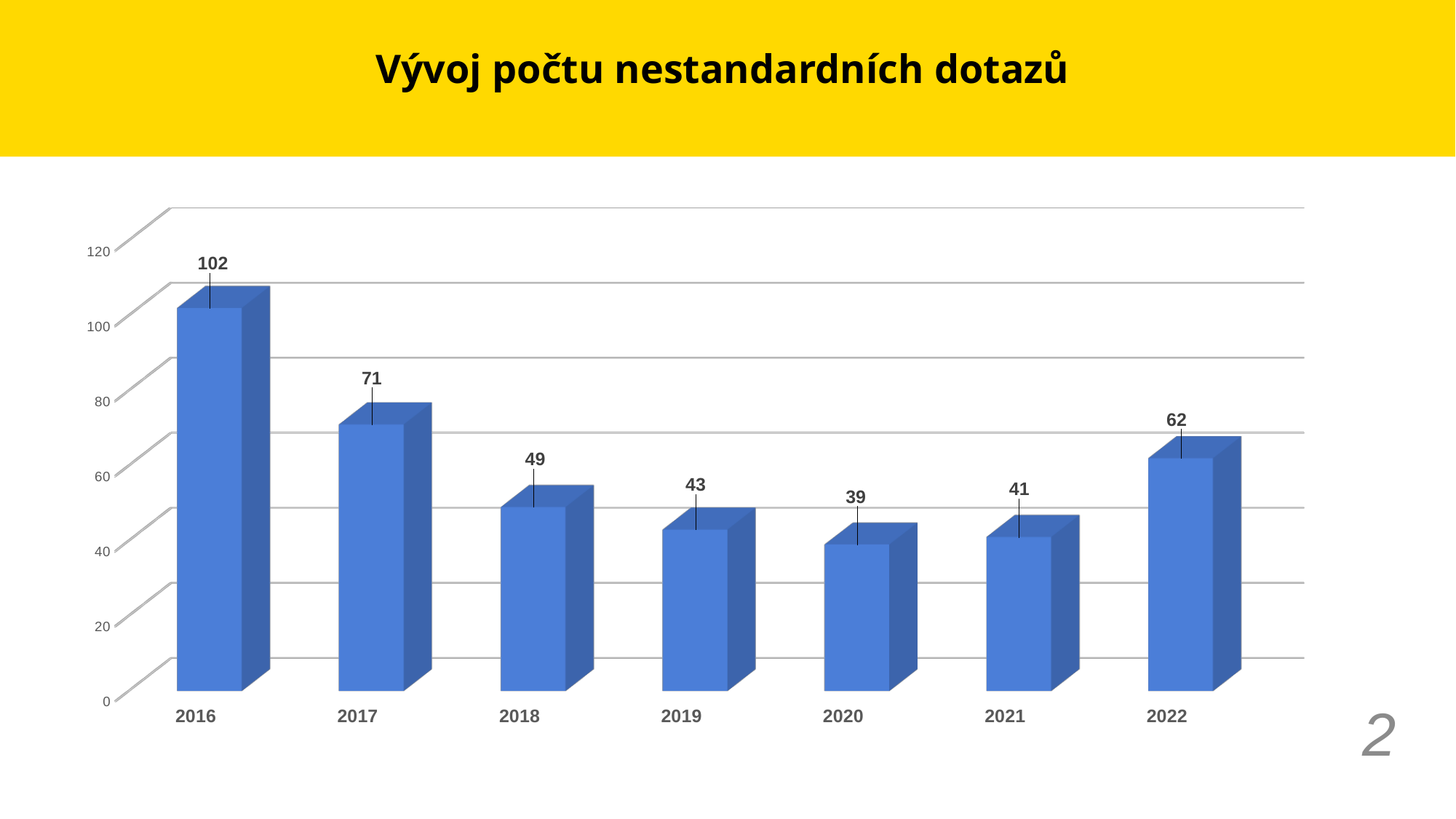
What is the value for 2016? 102 Is the value for 2017 greater or less than 60? greater Which year has the highest value? 2016 What is the value for 2022? 62 Which year has the lowest value? 2020 Which is larger, the value for 2018 or the value for 2019? 2018 How many years are shown on the x axis? 7 What is the title of the slide? Vývoj počtu nestandardních dotazů What is the difference between the values for 2022 and 2021? 21 What kind of chart is shown on the slide? bar chart What is the value for 2020? 39 What is the difference between the values for 2016 and 2017? 31